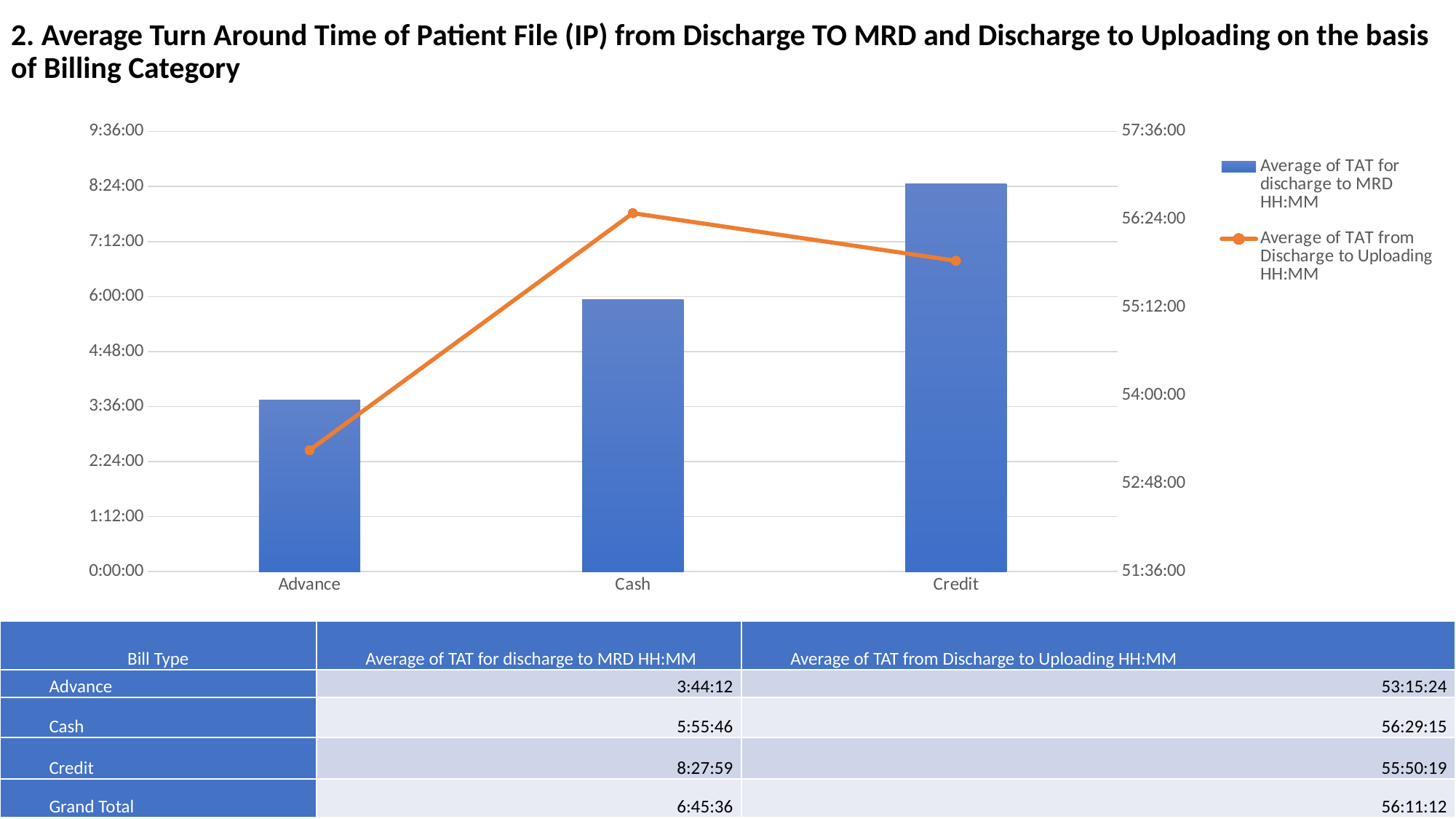
Which is larger, the Average of TAT for discharge to MRD for Cash or for Advance? Cash What is the Average of TAT for discharge to MRD HH:MM for Cash? 5:55:46 What is the Average of TAT from Discharge to Uploading HH:MM for Advance? 53:15:24 How many series does the chart legend list? 2 Which billing category has the lowest Average of TAT from Discharge to Uploading HH:MM? Advance Which billing category has the highest Average of TAT for discharge to MRD HH:MM? Credit Is the Average of TAT for discharge to MRD bar for Advance greater or less than 4:48:00? less How many billing categories are shown on the x axis of the chart? 3 Is the Average of TAT for discharge to MRD bar for Credit greater or less than 7:12:00? greater Which series is drawn as a line in the chart? Average of TAT from Discharge to Uploading HH:MM Which billing category has the highest Average of TAT from Discharge to Uploading HH:MM? Cash What is the Average of TAT from Discharge to Uploading HH:MM for Credit? 55:50:19